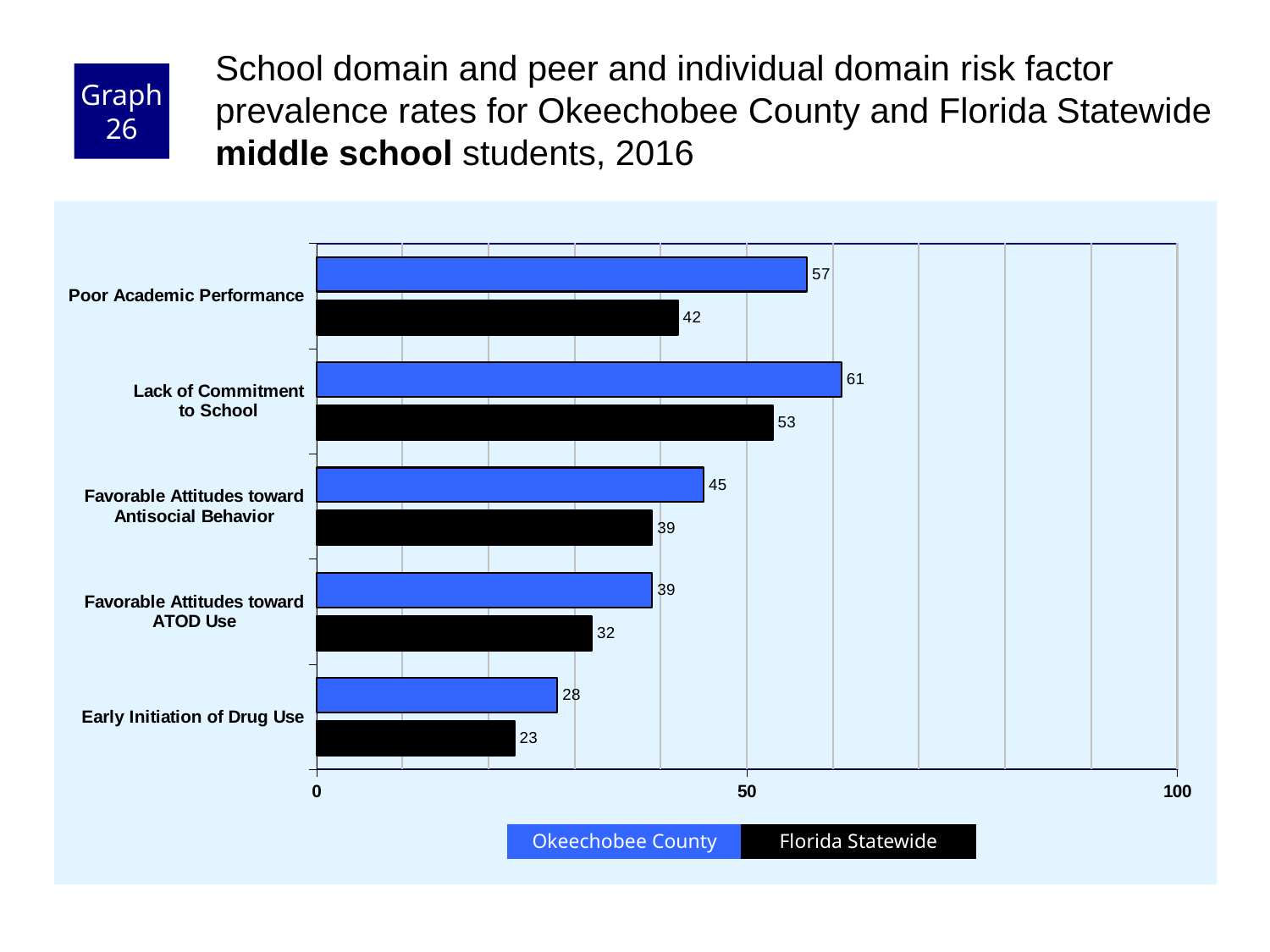
How many series does the legend list? 2 What is the difference between the Okeechobee County and Florida Statewide values for Poor Academic Performance? 15 Which risk factor has the highest Okeechobee County value? Lack of Commitment to School What is the Okeechobee County value for Early Initiation of Drug Use? 28 Which risk factor has the lowest Florida Statewide value? Early Initiation of Drug Use Is the Florida Statewide value for Favorable Attitudes toward Antisocial Behavior greater or less than 50? less What is the Okeechobee County value for Poor Academic Performance? 57 What is the Florida Statewide value for Lack of Commitment to School? 53 Which is larger for Favorable Attitudes toward ATOD Use: the Okeechobee County value or the Florida Statewide value? Okeechobee County Which colour represents Florida Statewide in the chart? black How many risk factor categories are shown on the chart? 5 What kind of chart is shown on the slide? bar chart